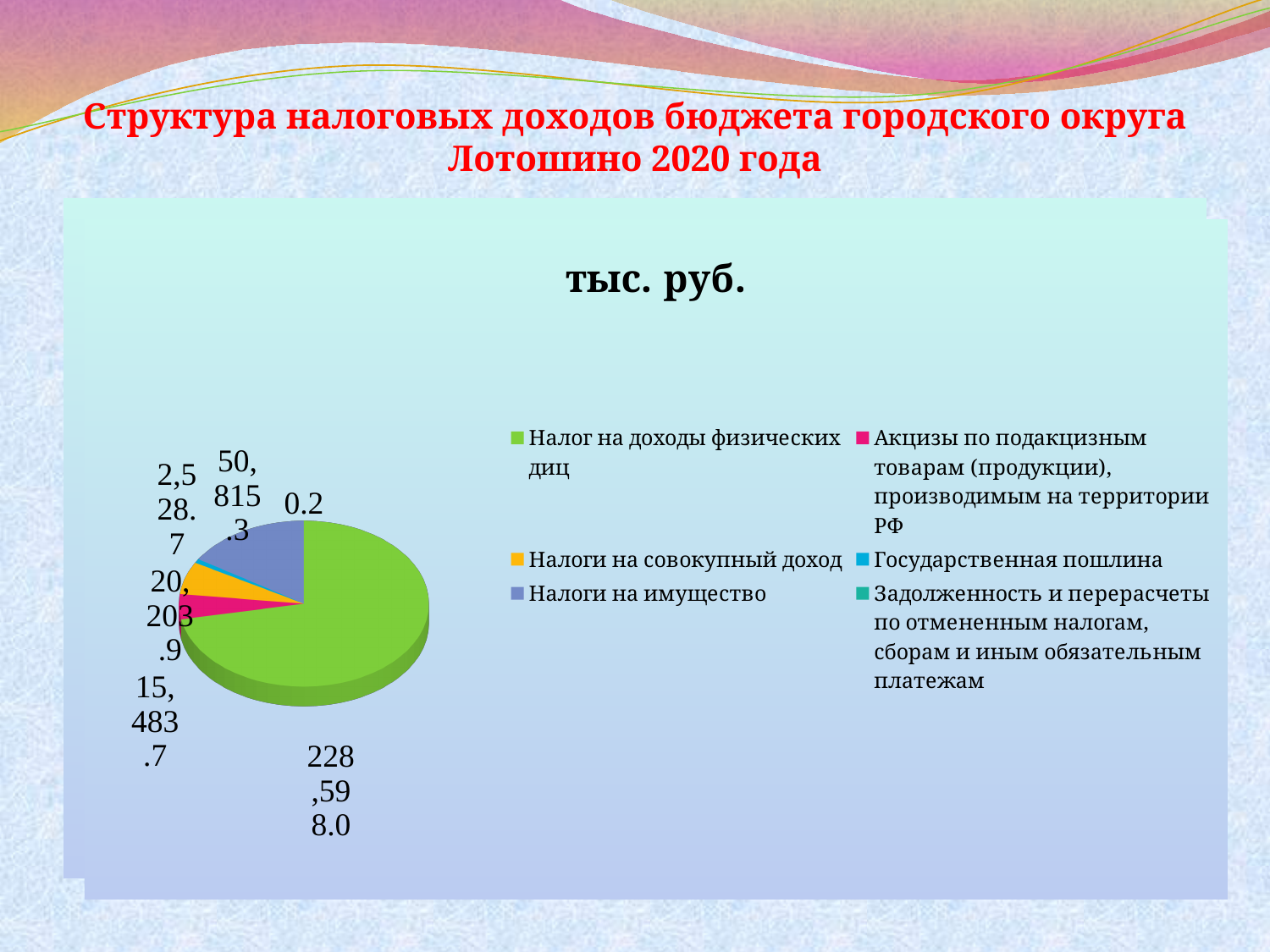
Which is larger: the slice for Налог на доходы физических лиц or the slice for Налоги на имущество? Налог на доходы физических диц What is the value shown for Налоги на имущество? 50,815.3 Which category has the largest slice in the pie chart? Налог на доходы физических диц What is the smallest value labelled on the pie chart? 0.2 What is the title shown above the pie chart? тыс. руб. What is the value of the largest slice in the pie chart? 228,598.0 What kind of chart is shown on the slide? Pie chart How many data labels are shown on the pie chart? 6 How many entries does the legend of the pie chart list? 6 What colour represents Налог на доходы физических лиц in the pie chart? Green What is the difference between the value for Налог на доходы физических лиц (228,598.0) and the value for Налоги на имущество (50,815.3)? 177,782.7